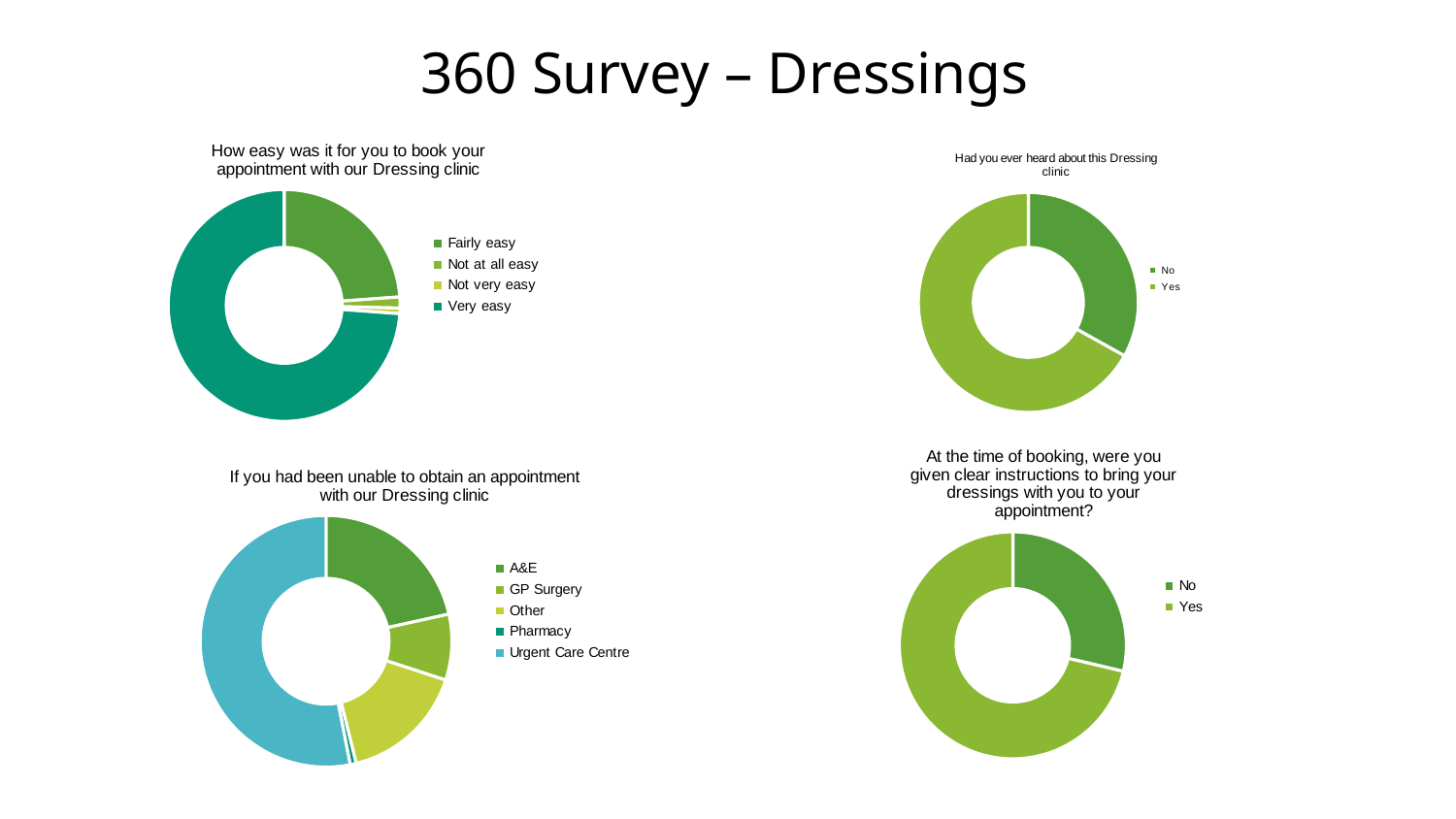
How many categories does the legend list in the chart titled "Had you ever heard about this Dressing clinic"? 2 In the chart titled "If you had been unable to obtain an appointment with our Dressing clinic", which category has the smallest share? Pharmacy In the chart titled "If you had been unable to obtain an appointment with our Dressing clinic", which category has the largest share? Urgent Care Centre In the chart titled "How easy was it for you to book your appointment with our Dressing clinic", which is larger: Fairly easy or Very easy? Very easy In the chart titled "Had you ever heard about this Dressing clinic", which response has the larger share? Yes How many charts are shown on the slide? 4 What kind of chart is the chart titled "How easy was it for you to book your appointment with our Dressing clinic"? Doughnut chart How many categories does the legend list in the chart titled "If you had been unable to obtain an appointment with our Dressing clinic"? 5 In the chart titled "How easy was it for you to book your appointment with our Dressing clinic", which category has the largest share? Very easy In the chart titled "If you had been unable to obtain an appointment with our Dressing clinic", which is larger: A&E or GP Surgery? A&E How many categories does the legend list in the chart titled "How easy was it for you to book your appointment with our Dressing clinic"? 4